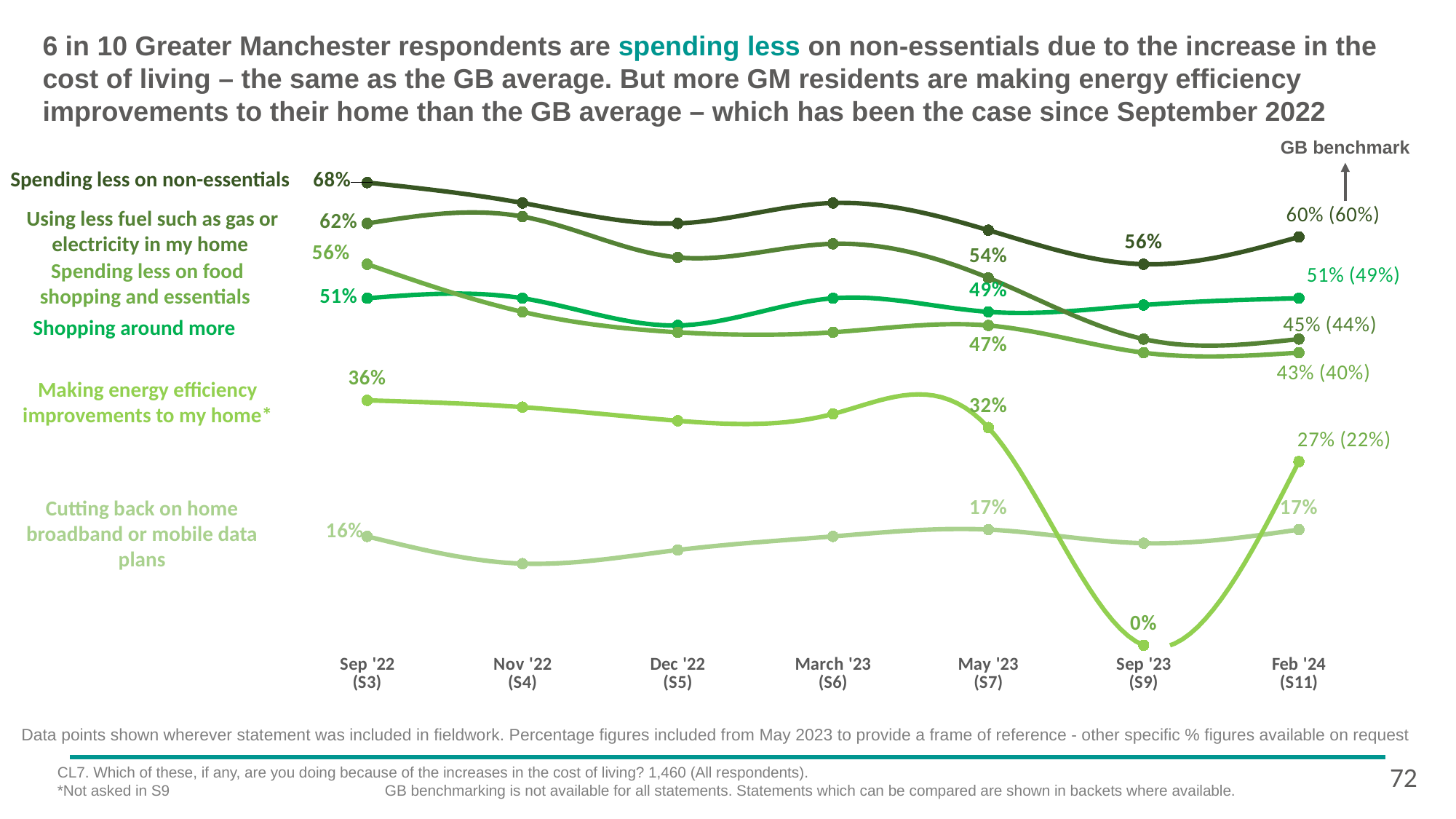
Which statement had the lowest percentage in Sep '22 (S3)? Cutting back on home broadband or mobile data plans What percentage of respondents were cutting back on home broadband or mobile data plans in May '23 (S7)? 17% What percentage of respondents were spending less on non-essentials in Feb '24 (S11)? 60% In Feb '24, is the Greater Manchester value for making energy efficiency improvements (27%) higher or lower than the GB benchmark (22%)? Higher How many statements (series) are plotted on the chart? 6 What percentage of respondents were spending less on non-essentials in Sep '22 (S3)? 68% Which statement had the highest percentage in Sep '22 (S3)? Spending less on non-essentials What percentage of respondents were making energy efficiency improvements to their home in Sep '22 (S3)? 36% By how many percentage points did 'Spending less on non-essentials' fall between Sep '22 and Feb '24? 8 percentage points How many survey waves (time points) are shown along the x axis? 7 What kind of chart is shown on the slide? Line chart What is the GB benchmark shown in brackets for making energy efficiency improvements to my home in Feb '24? 22%